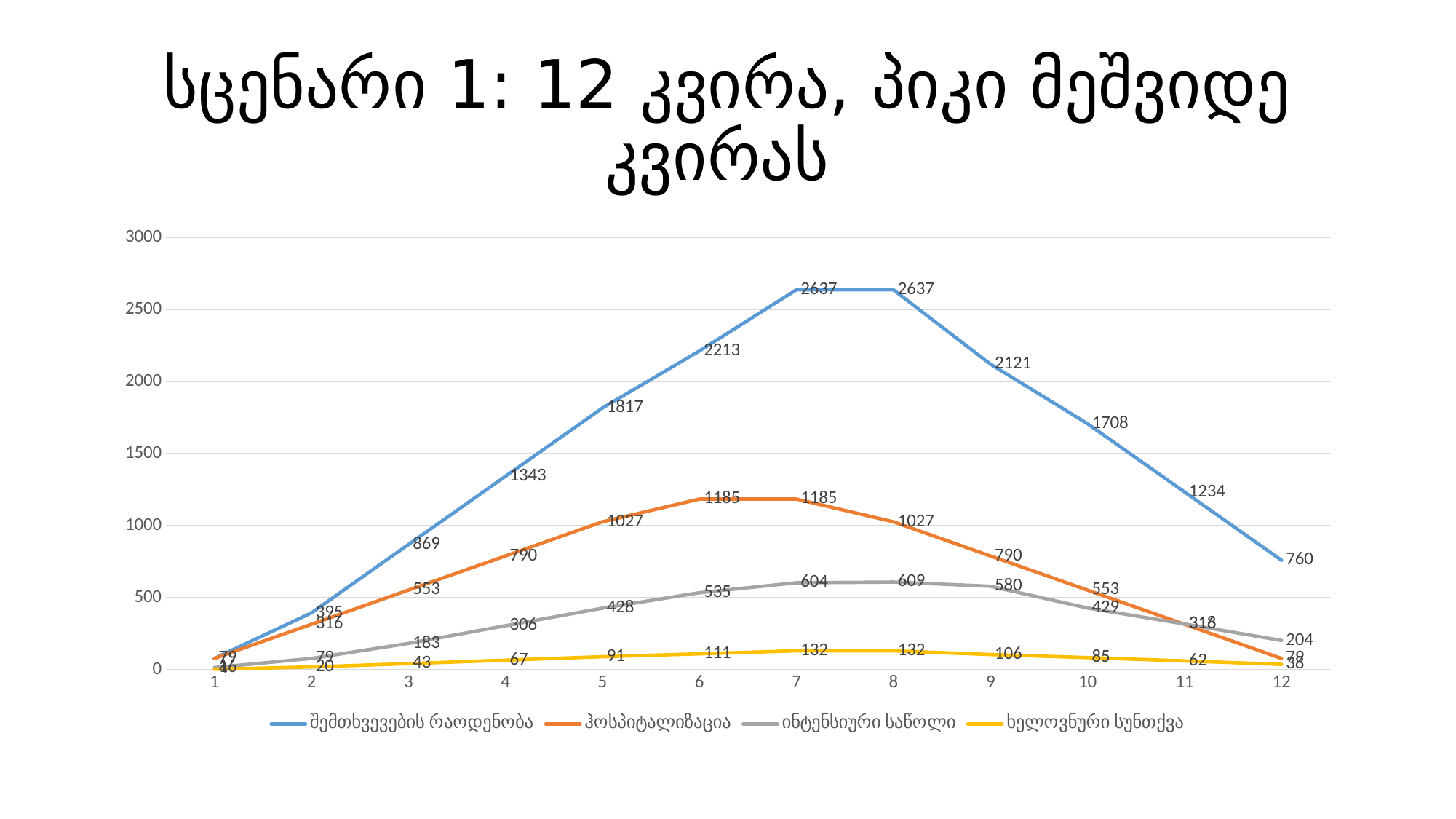
Does შემთხვევების რაოდენობა rise or fall from week 8 to week 12? fall What is the value of ხელოვნური სუნთქვა at week 9? 106 What is the value of ჰოსპიტალიზაცია at week 5? 1027 What type of chart is shown on the slide? line chart What is the value of შემთხვევების რაოდენობა at week 7? 2637 What is the value of ინტენსიური საწოლი at week 8? 609 How many weeks (x-axis points) are plotted on the chart? 12 Which is larger: ჰოსპიტალიზაცია at week 4 or ინტენსიური საწოლი at week 7? ჰოსპიტალიზაცია at week 4 What is the difference between შემთხვევების რაოდენობა at week 6 and at week 5? 396 At which week does ინტენსიური საწოლი reach its highest value? 8 How many series does the legend list? 4 Which series is drawn in yellow? ხელოვნური სუნთქვა